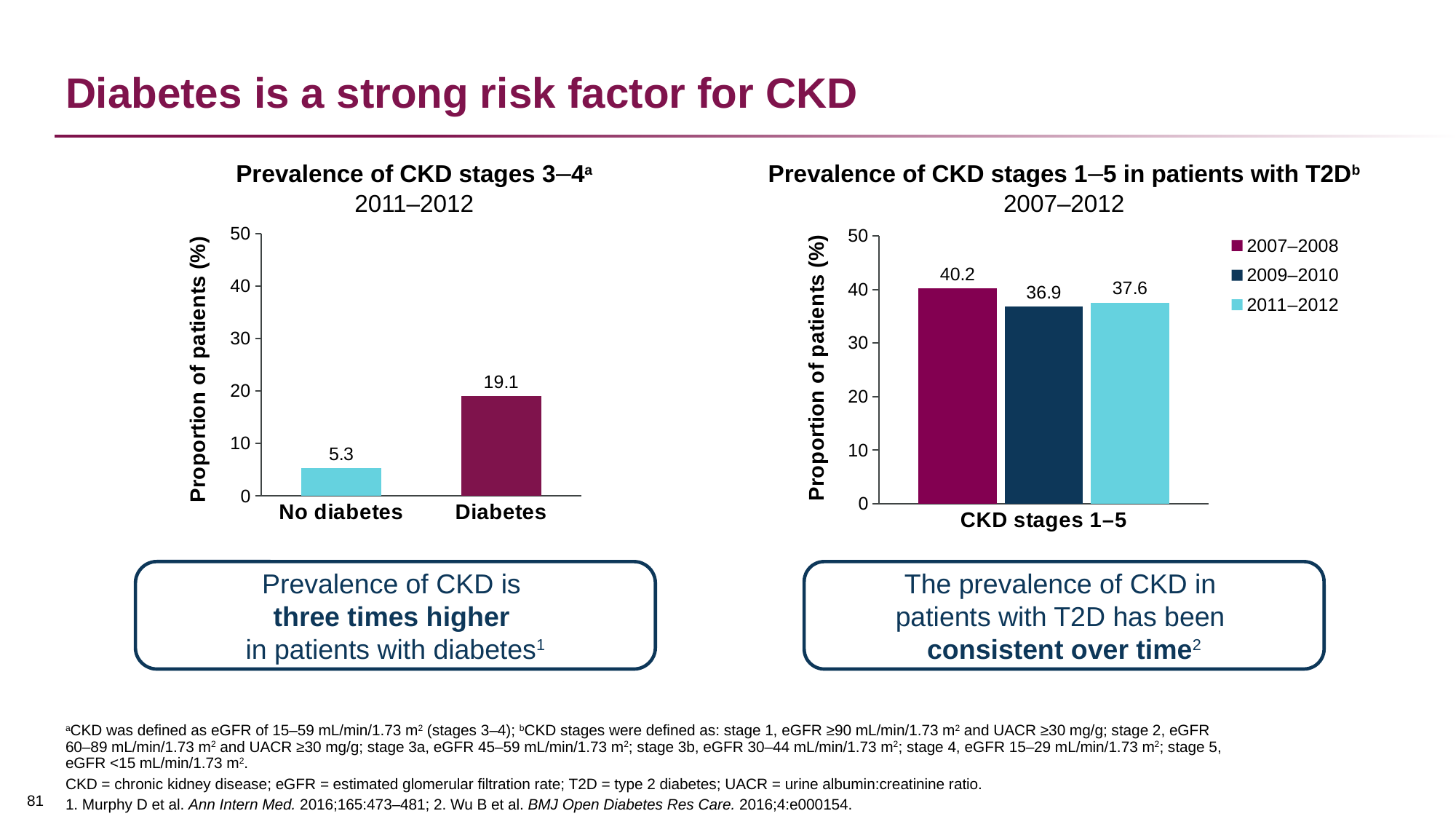
In the left chart (Prevalence of CKD stages 3–4), how many categories are shown on the x axis? 2 In the right chart (Prevalence of CKD stages 1–5 in patients with T2D), what is the value for 2007–2008? 40.2 What type of chart is the left chart (Prevalence of CKD stages 3–4)? Bar chart In the left chart (Prevalence of CKD stages 3–4, 2011–2012), what is the proportion of patients with CKD in the No diabetes group? 5.3 In the left chart (Prevalence of CKD stages 3–4, 2011–2012), what is the proportion of patients with CKD in the Diabetes group? 19.1 In the left chart (Prevalence of CKD stages 3–4), what is the difference in prevalence between the Diabetes and No diabetes groups? 13.8 In the left chart (Prevalence of CKD stages 3–4), which group has the higher prevalence of CKD? Diabetes In the right chart (Prevalence of CKD stages 1–5 in patients with T2D), which period has the lowest prevalence? 2009–2010 In the right chart (Prevalence of CKD stages 1–5 in patients with T2D), how many series does the legend list? 3 In the right chart (Prevalence of CKD stages 1–5 in patients with T2D), what is the value for 2011–2012? 37.6 In the right chart (Prevalence of CKD stages 1–5 in patients with T2D), what is the value for 2009–2010? 36.9 In the right chart (Prevalence of CKD stages 1–5 in patients with T2D), what is the difference between the 2007–2008 and 2011–2012 values? 2.6